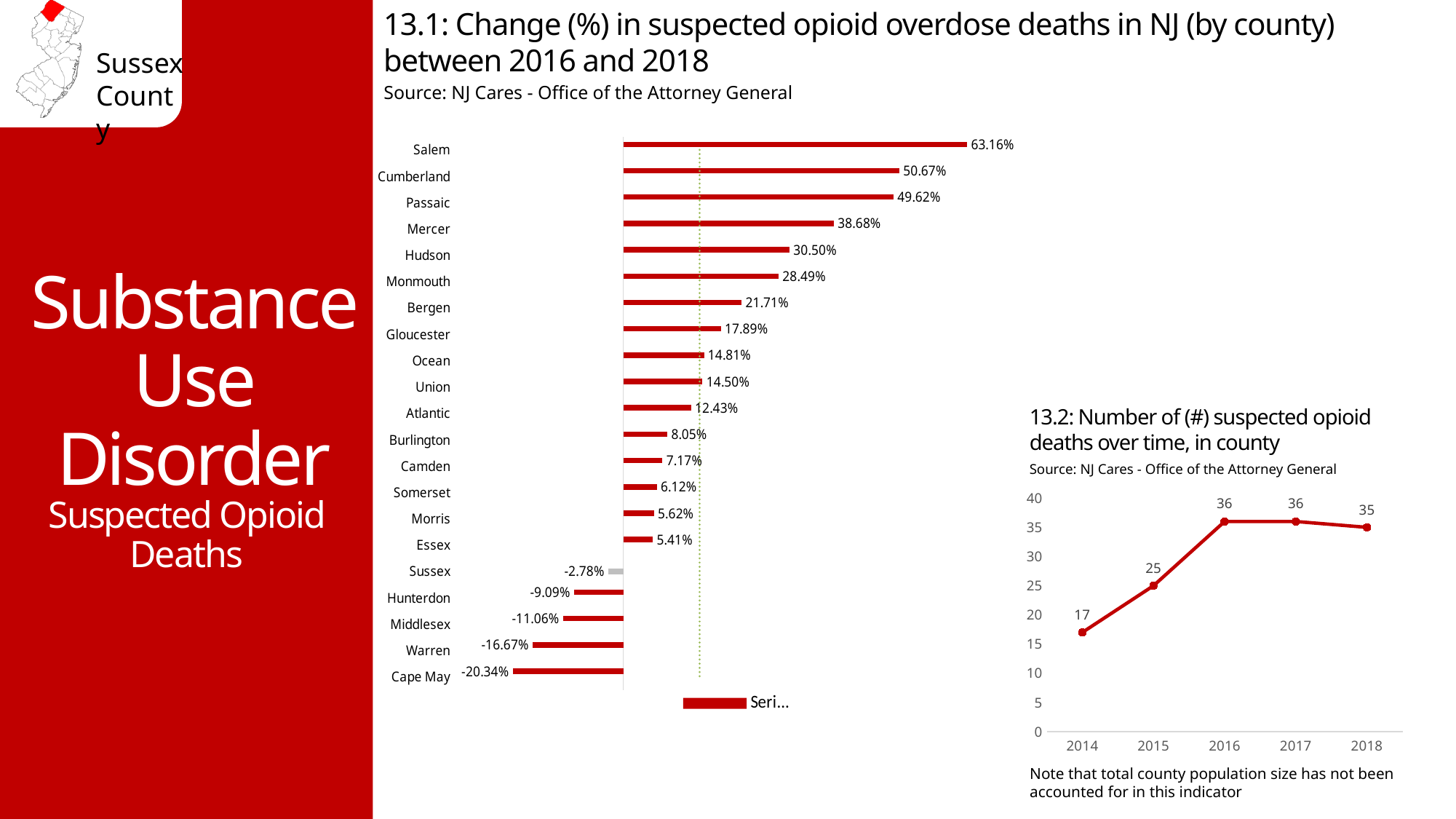
In chart 13.1, which county has the highest change in suspected opioid overdose deaths? Salem In chart 13.2, what is the difference between the values for 2016 and 2015? 11 In chart 13.1 (Change (%) in suspected opioid overdose deaths in NJ by county), what is the value for Sussex? -2.78% In chart 13.1, which is larger, the value for Passaic or the value for Mercer? Passaic In chart 13.1, which county has the lowest change in suspected opioid overdose deaths? Cape May In chart 13.1, how many counties are shown? 21 In chart 13.1, what is the value for Hudson? 30.50% In chart 13.2 (Number of suspected opioid deaths over time, in county), what is the value for 2014? 17 In chart 13.2, what is the value for 2018? 35 What kind of chart is chart 13.1? Bar chart In chart 13.1, what is the difference between the values for Salem and Cumberland? 12.49% What kind of chart is chart 13.2? Line chart